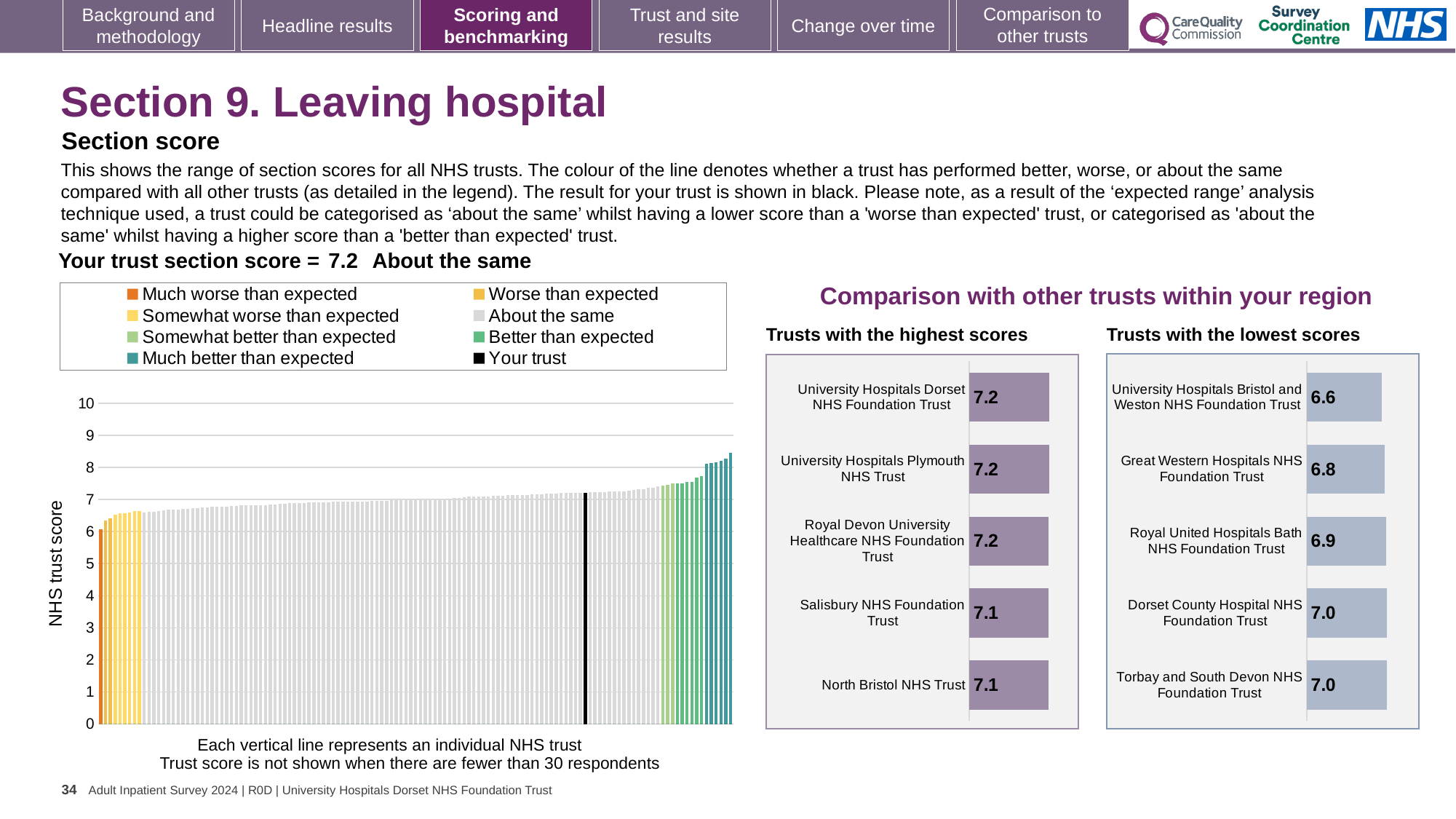
How many trusts are listed in the 'Trusts with the highest scores' chart? 5 What kind of chart is the main 'NHS trust score' chart on the left of the slide? Bar chart In the 'Trusts with the lowest scores' chart, which trust has the lowest score? University Hospitals Bristol and Weston NHS Foundation Trust In the 'Trusts with the highest scores' chart, what is the score for North Bristol NHS Trust? 7.1 In the 'Trusts with the highest scores' chart, what is the score for Salisbury NHS Foundation Trust? 7.1 How many trusts are listed in the 'Trusts with the lowest scores' chart? 5 In the 'Trusts with the lowest scores' chart, what is the score for Great Western Hospitals NHS Foundation Trust? 6.8 In the main 'NHS trust score' chart on the left, do the trust scores rise or fall from left to right? Rise In the 'Trusts with the lowest scores' chart, what is the difference between the scores of Torbay and South Devon NHS Foundation Trust and University Hospitals Bristol and Weston NHS Foundation Trust? 0.4 In the 'Trusts with the lowest scores' chart, what is the difference between the scores of Royal United Hospitals Bath NHS Foundation Trust and University Hospitals Bristol and Weston NHS Foundation Trust? 0.3 How many entries does the legend of the main 'NHS trust score' chart on the left list? 8 In the 'Trusts with the lowest scores' chart, which has the higher score: Great Western Hospitals NHS Foundation Trust or Dorset County Hospital NHS Foundation Trust? Dorset County Hospital NHS Foundation Trust